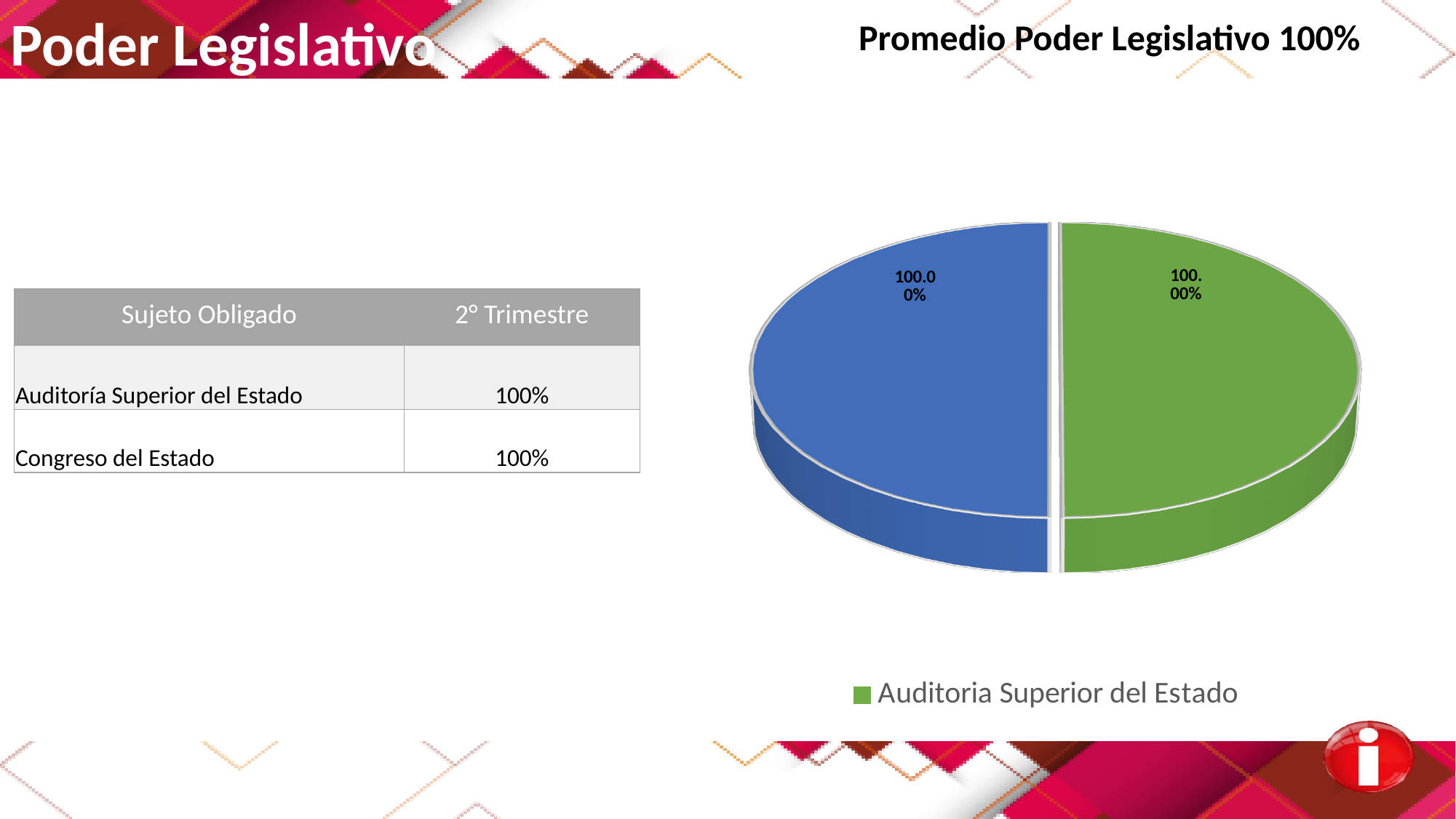
How many slices does the pie chart have? 2 What is the data label shown on the blue slice of the pie chart? 100.00% Which category does the legend of the pie chart list? Auditoria Superior del Estado What colour is the slice for Auditoria Superior del Estado in the pie chart? green What kind of chart is shown on the slide? pie chart How many entries does the pie chart's legend list? 1 What is the data label shown on the green slice of the pie chart? 100.00%